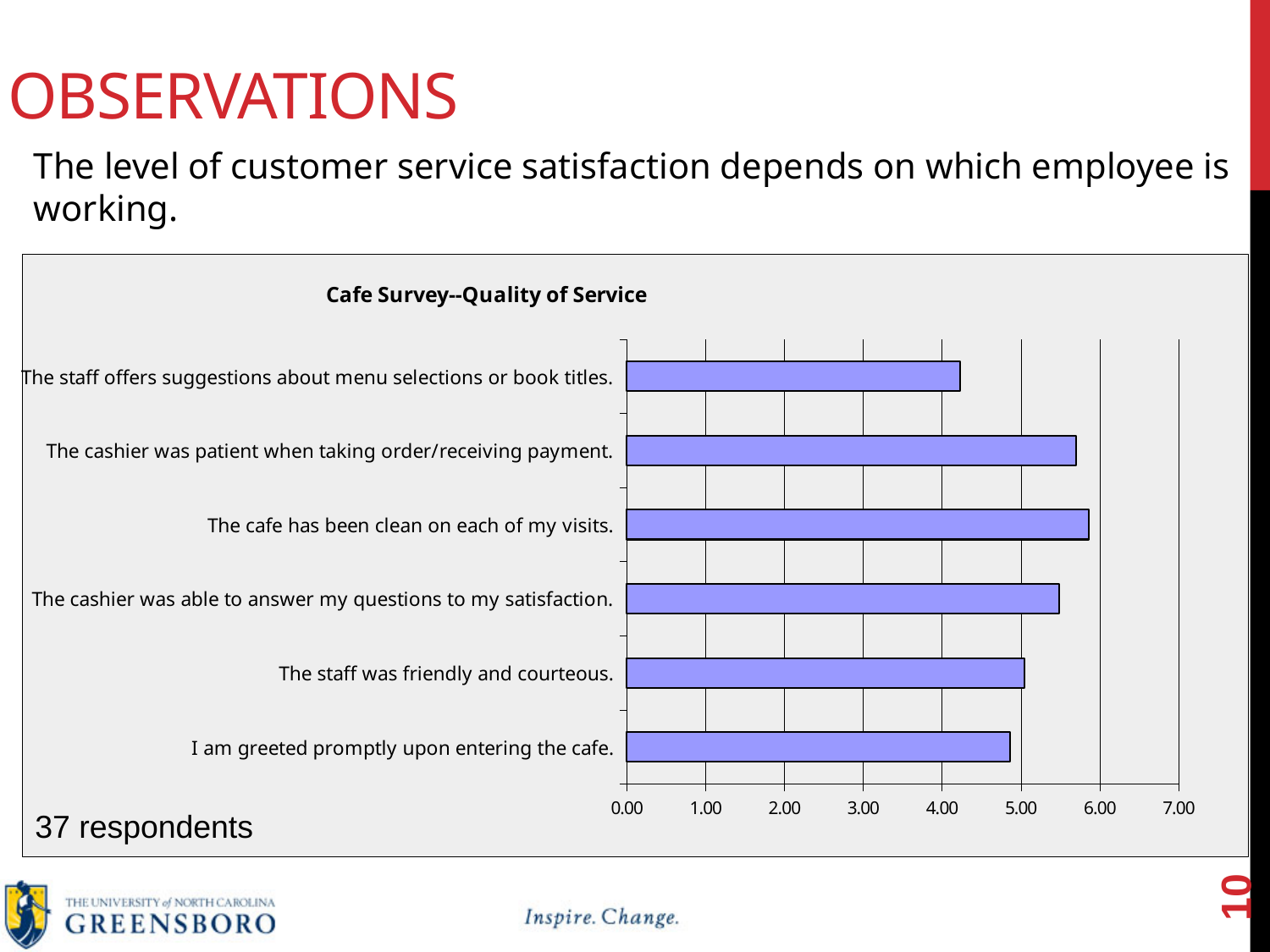
Is the value for "The cashier was able to answer my questions to my satisfaction." greater or less than 5.00? greater What is the maximum value shown on the horizontal axis of the chart? 7.00 What is the title of the chart? Cafe Survey--Quality of Service What kind of chart is shown on the slide? bar chart Is the value for "The cashier was patient when taking order/receiving payment." greater or less than 5.00? greater Is the value for "The staff offers suggestions about menu selections or book titles." greater or less than 5.00? less Which survey statement has the lowest value? The staff offers suggestions about menu selections or book titles. Which is larger: the value for "The cashier was patient when taking order/receiving payment." or the value for "The staff offers suggestions about menu selections or book titles."? The cashier was patient when taking order/receiving payment. How many survey statements (categories) are plotted in the chart? 6 Which is larger: the value for "The cafe has been clean on each of my visits." or the value for "I am greeted promptly upon entering the cafe."? The cafe has been clean on each of my visits. Which survey statement has the highest value? The cafe has been clean on each of my visits.